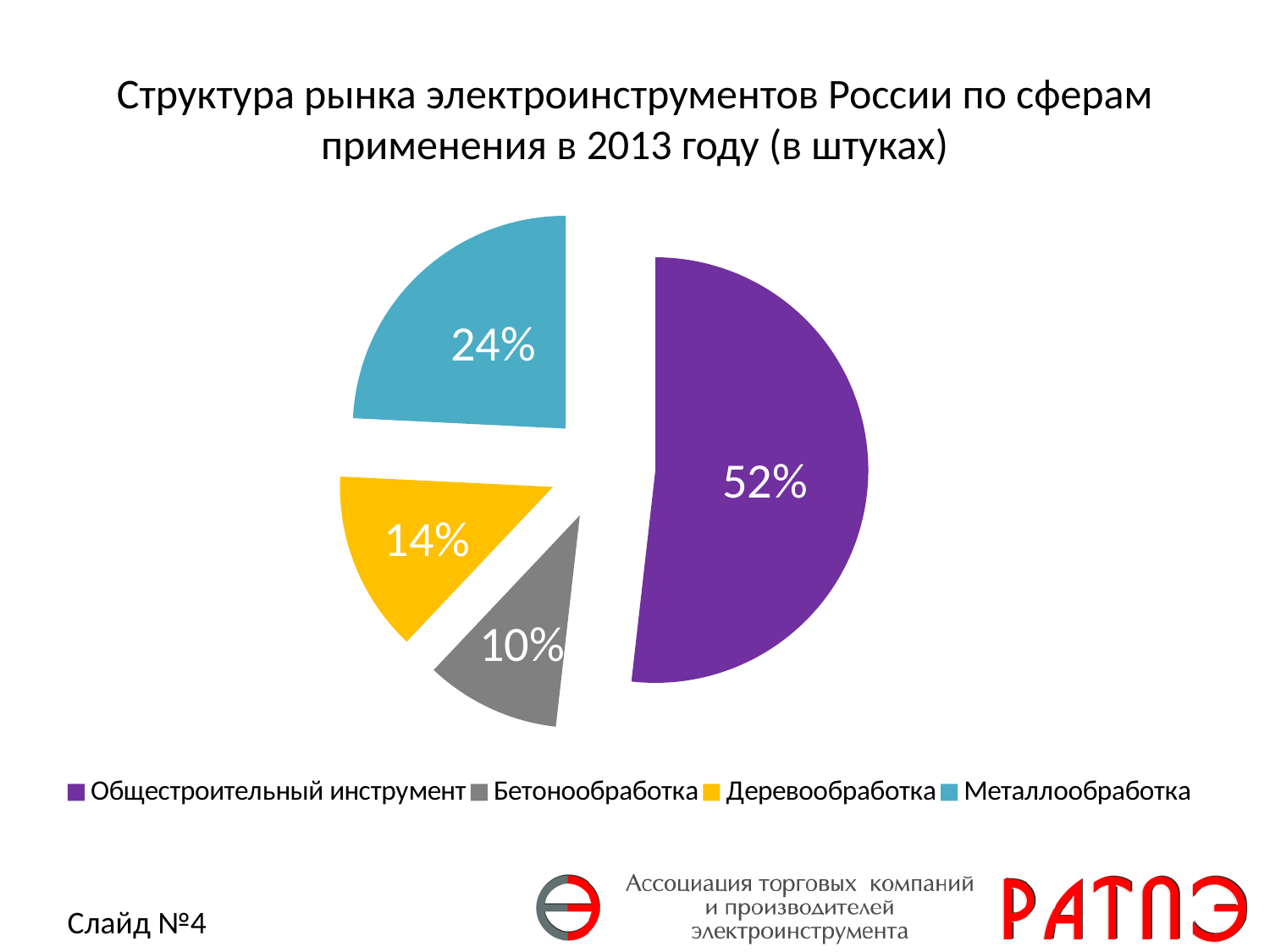
How many categories are shown in the pie chart? 4 What share of the pie does Бетонообработка have? 10% What colour is the slice for Деревообработка? Yellow Which is larger, the share for Металлообработка or the share for Деревообработка? Металлообработка Which category has the smallest slice of the pie? Бетонообработка What is the difference in percentage points between Деревообработка and Бетонообработка? 4 What kind of chart is shown on the slide? Pie chart Which category has the largest slice of the pie? Общестроительный инструмент What share of the pie does Металлообработка have? 24% What is the difference in percentage points between Общестроительный инструмент and Металлообработка? 28 What share of the pie does Общестроительный инструмент have? 52%